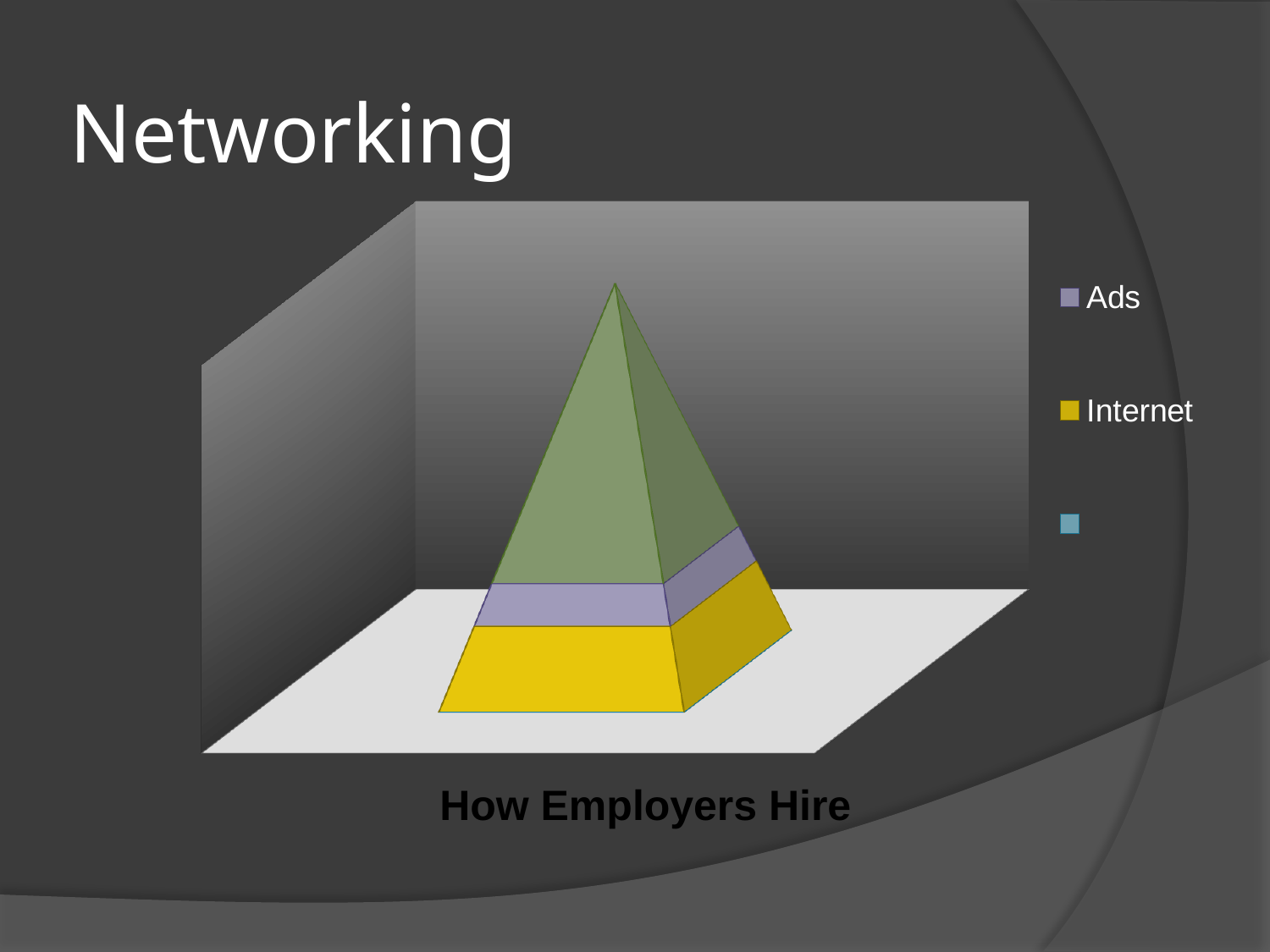
How many categories are plotted along the base of the chart? 1 What is the category label shown beneath the chart? How Employers Hire How many entries does the chart legend list? 3 Which of the two labelled series, Ads or Internet, has the smaller segment in the pyramid? Ads What kind of chart is shown on the slide? pyramid chart Which segment of the pyramid is larger, Ads or Internet? Internet Which legend entry is shown in yellow? Internet